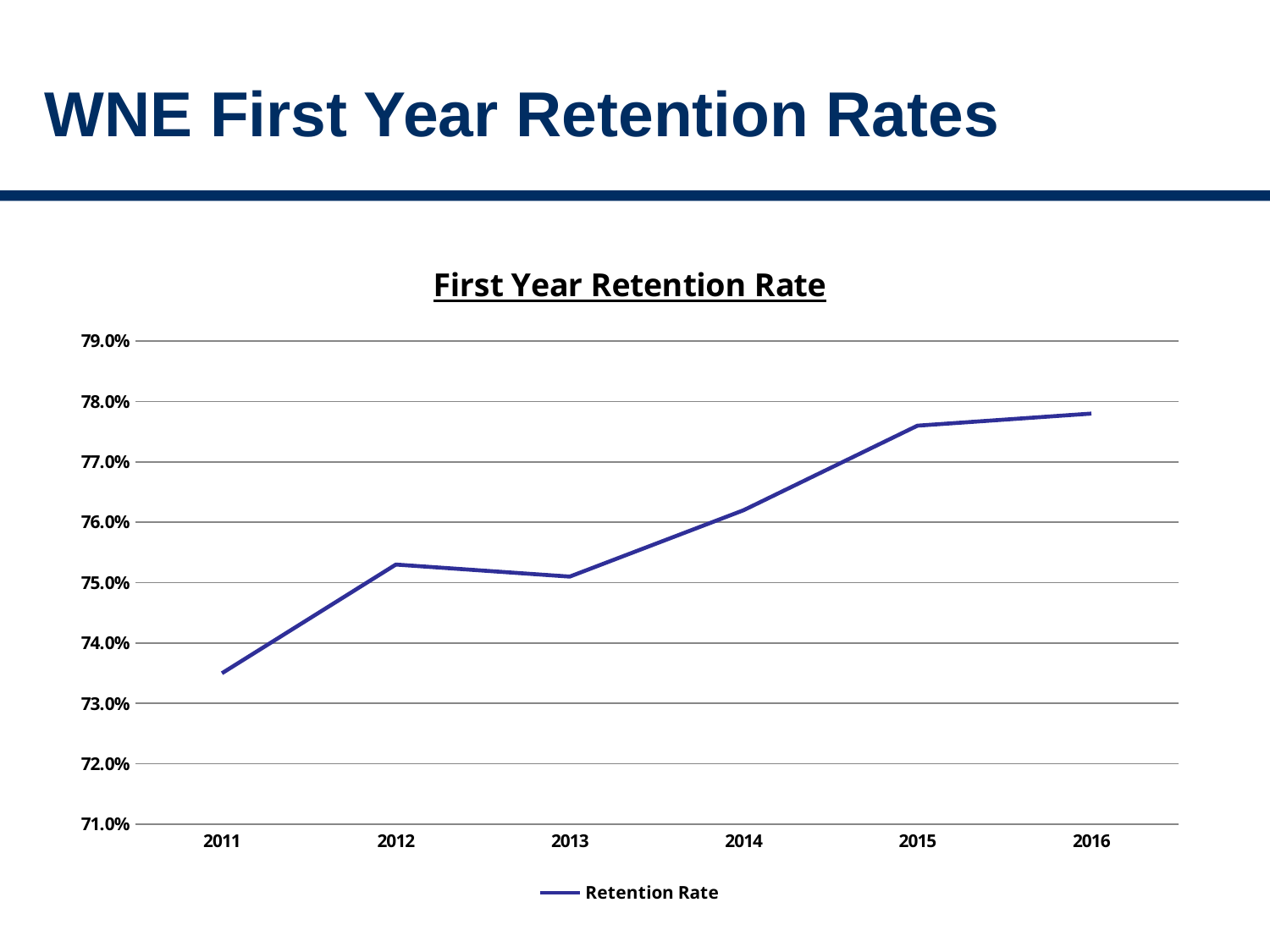
Is the retention rate for 2015 greater or less than 78.0%? less Is the retention rate for 2014 greater or less than 76.0%? greater What kind of chart is shown on the slide? line chart What is the title of the chart? First Year Retention Rate Which year has the lowest retention rate? 2011 Is the retention rate for 2012 greater or less than 75.0%? greater How many years are plotted on the x axis? 6 Overall, does the retention rate rise or fall from 2011 to 2016? rise What is the name of the series shown in the legend? Retention Rate How many series does the legend list? 1 Which year has the higher retention rate, 2011 or 2014? 2014